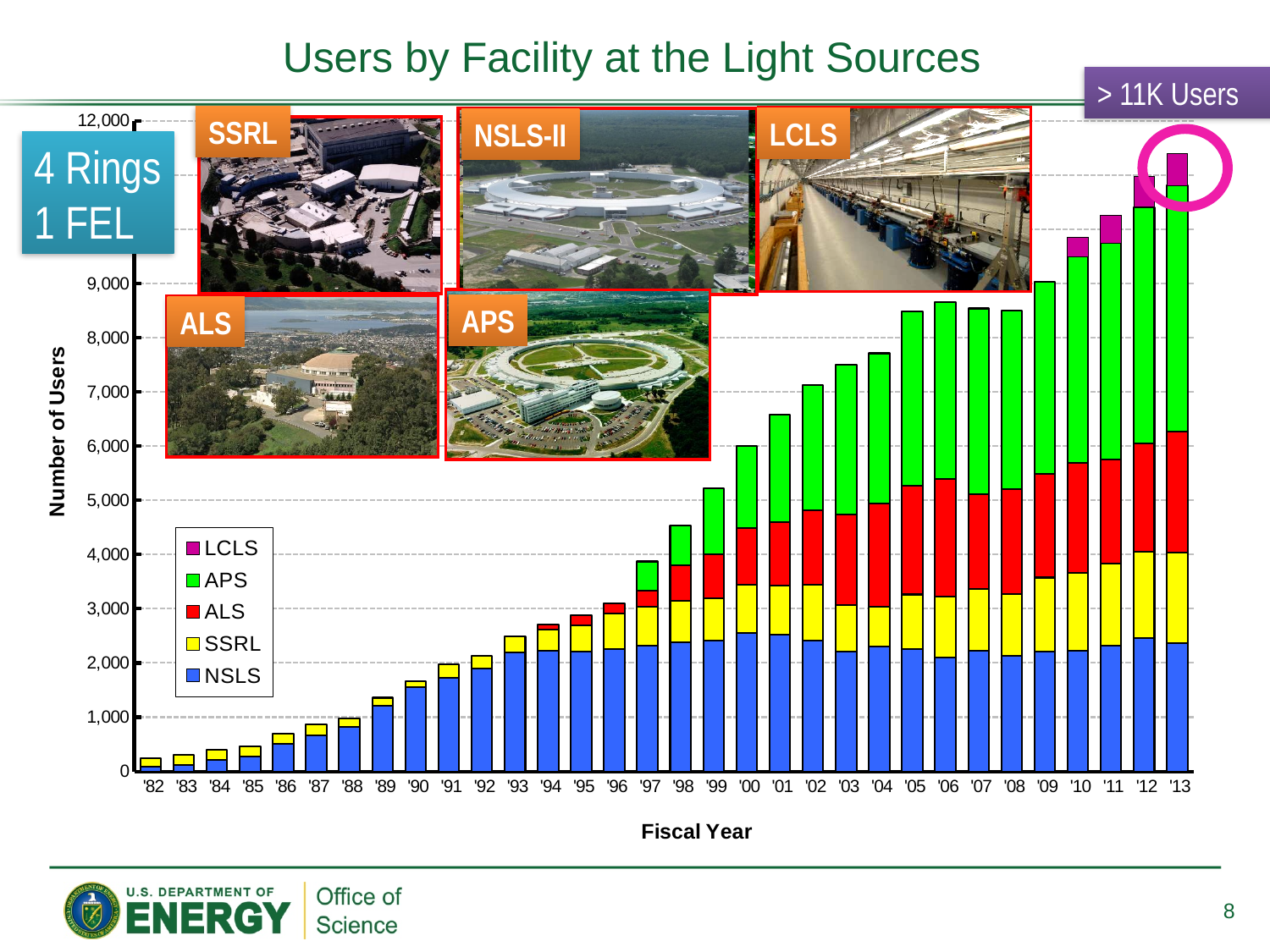
Is the total number of users in fiscal year '13 greater or less than 11,000? greater Which fiscal year has the highest total number of users? '13 Overall, do the total number of users rise or fall from '82 to '13? Rise Which fiscal year has the lowest total number of users? '82 What is the label of the y axis? Number of Users Is the total number of users in fiscal year '00 greater or less than 7,000? less How many series does the chart legend list? 5 How many fiscal years are plotted along the x axis? 32 What kind of chart is shown on the slide? Stacked bar chart Which facilities are listed in the chart legend? LCLS, APS, ALS, SSRL, NSLS Is the total number of users in fiscal year '82 greater or less than 1,000? less Which fiscal year has more total users, '12 or '06? '12